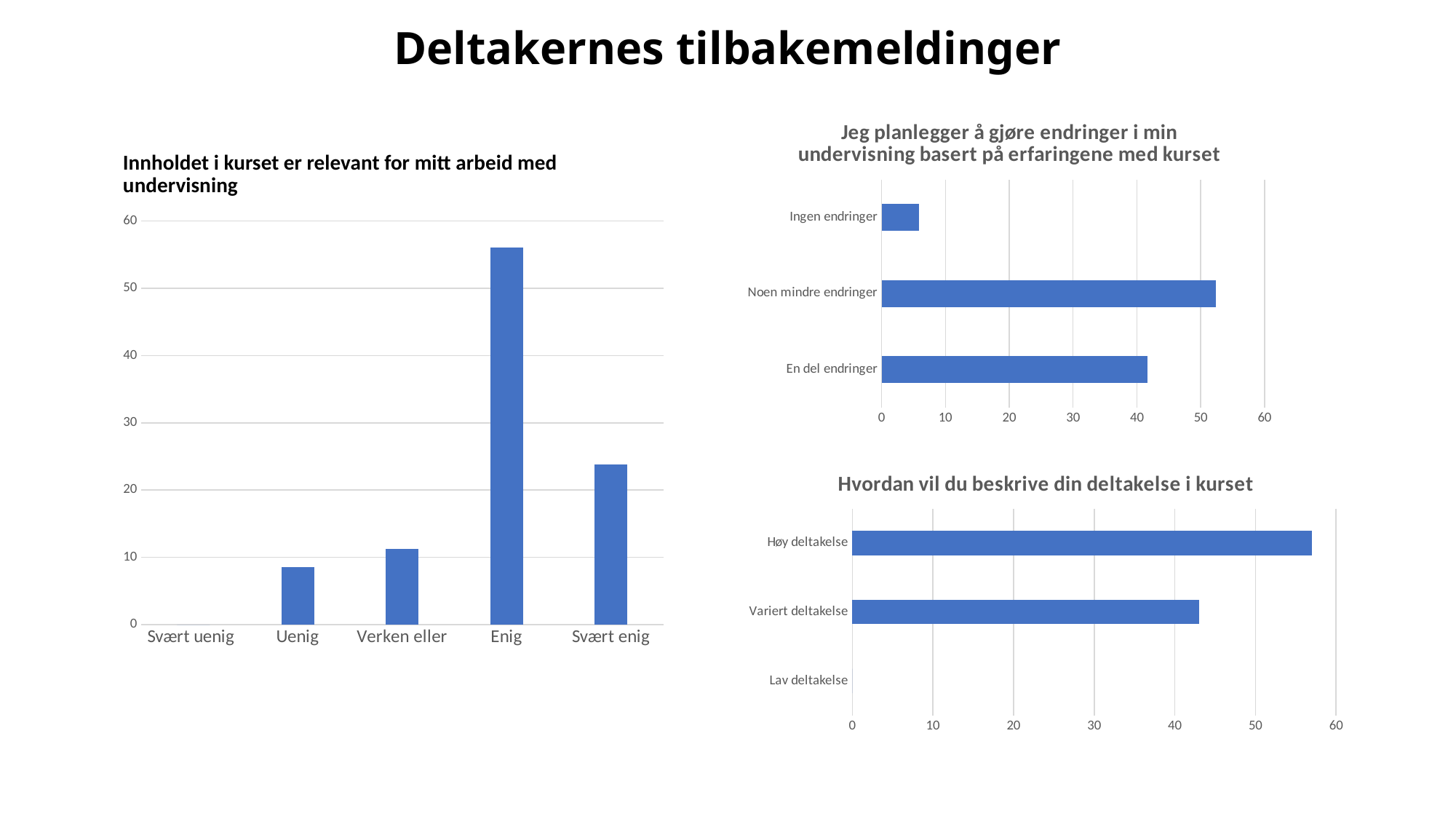
In the chart 'Jeg planlegger å gjøre endringer i min undervisning basert på erfaringene med kurset', which category has the lowest value? Ingen endringer In the chart 'Hvordan vil du beskrive din deltakelse i kurset', which category has the highest value? Høy deltakelse In the chart 'Jeg planlegger å gjøre endringer i min undervisning basert på erfaringene med kurset', is the value for En del endringer greater or less than 40? greater In the chart 'Innholdet i kurset er relevant for mitt arbeid med undervisning', is the value for Uenig greater or less than 10? less In the chart 'Innholdet i kurset er relevant for mitt arbeid med undervisning', which is larger, Svært enig or Verken eller? Svært enig How many categories are shown on the x axis of the chart 'Innholdet i kurset er relevant for mitt arbeid med undervisning'? 5 In the chart 'Jeg planlegger å gjøre endringer i min undervisning basert på erfaringene med kurset', which category has the highest value? Noen mindre endringer How many charts are shown on the slide? 3 In the chart 'Hvordan vil du beskrive din deltakelse i kurset', is the value for Variert deltakelse greater or less than 50? less What kind of chart is 'Innholdet i kurset er relevant for mitt arbeid med undervisning'? bar chart In the chart 'Innholdet i kurset er relevant for mitt arbeid med undervisning', which category has the highest value? Enig